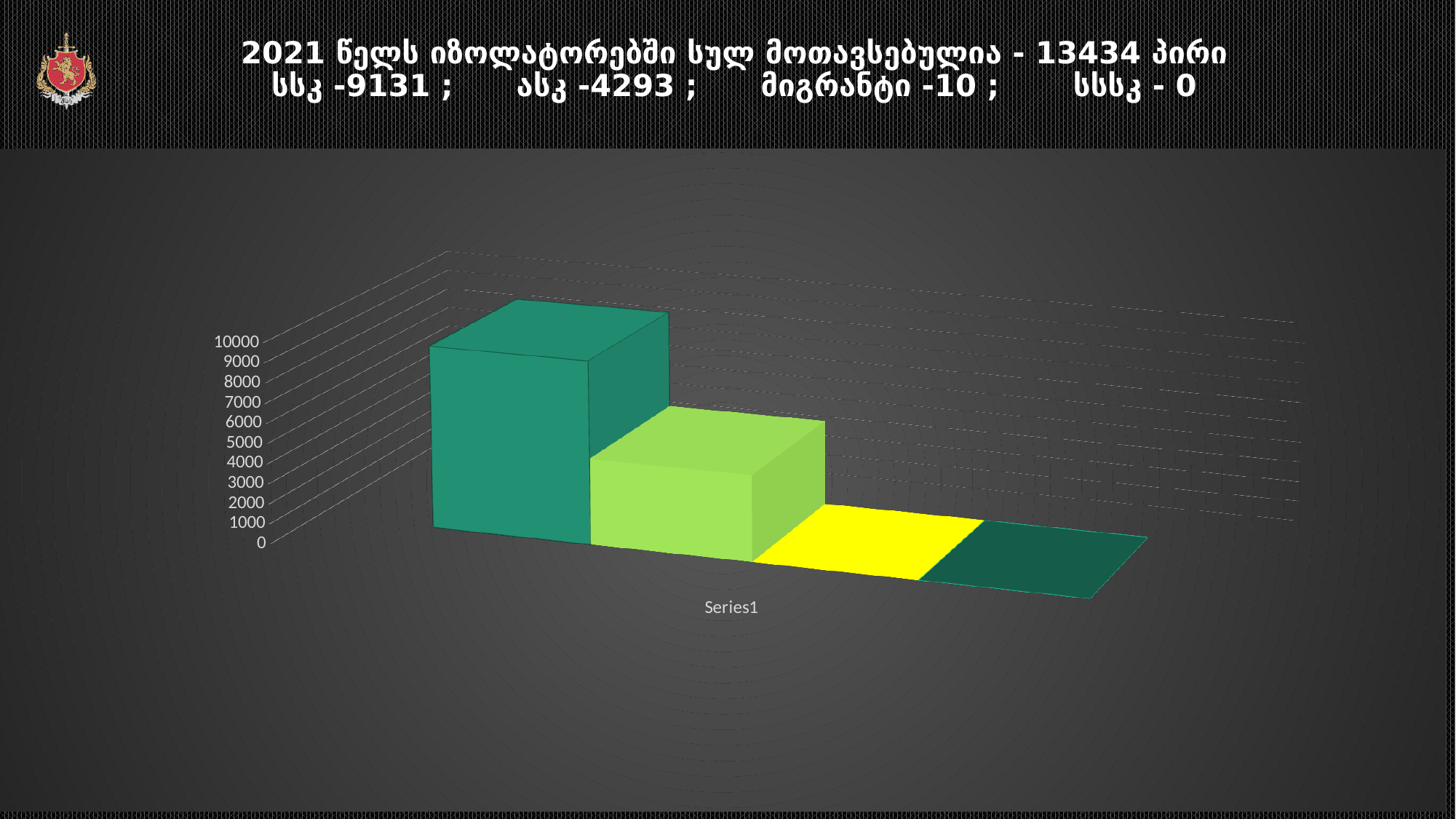
How many bars are plotted in the chart? 4 Is the value of the second (light green) bar greater or less than 5000? less Which is larger, the leftmost (teal) bar or the second (light green) bar? the leftmost (teal) bar What label is shown beneath the bars on the horizontal axis? Series1 What is the highest tick value shown on the vertical axis of the chart? 10000 Is the value of the yellow bar greater or less than 1000? less Is the value of the second (light green) bar greater or less than 3000? greater Which bar is the tallest in the chart? the leftmost (teal) bar What kind of chart is shown on the slide? bar chart